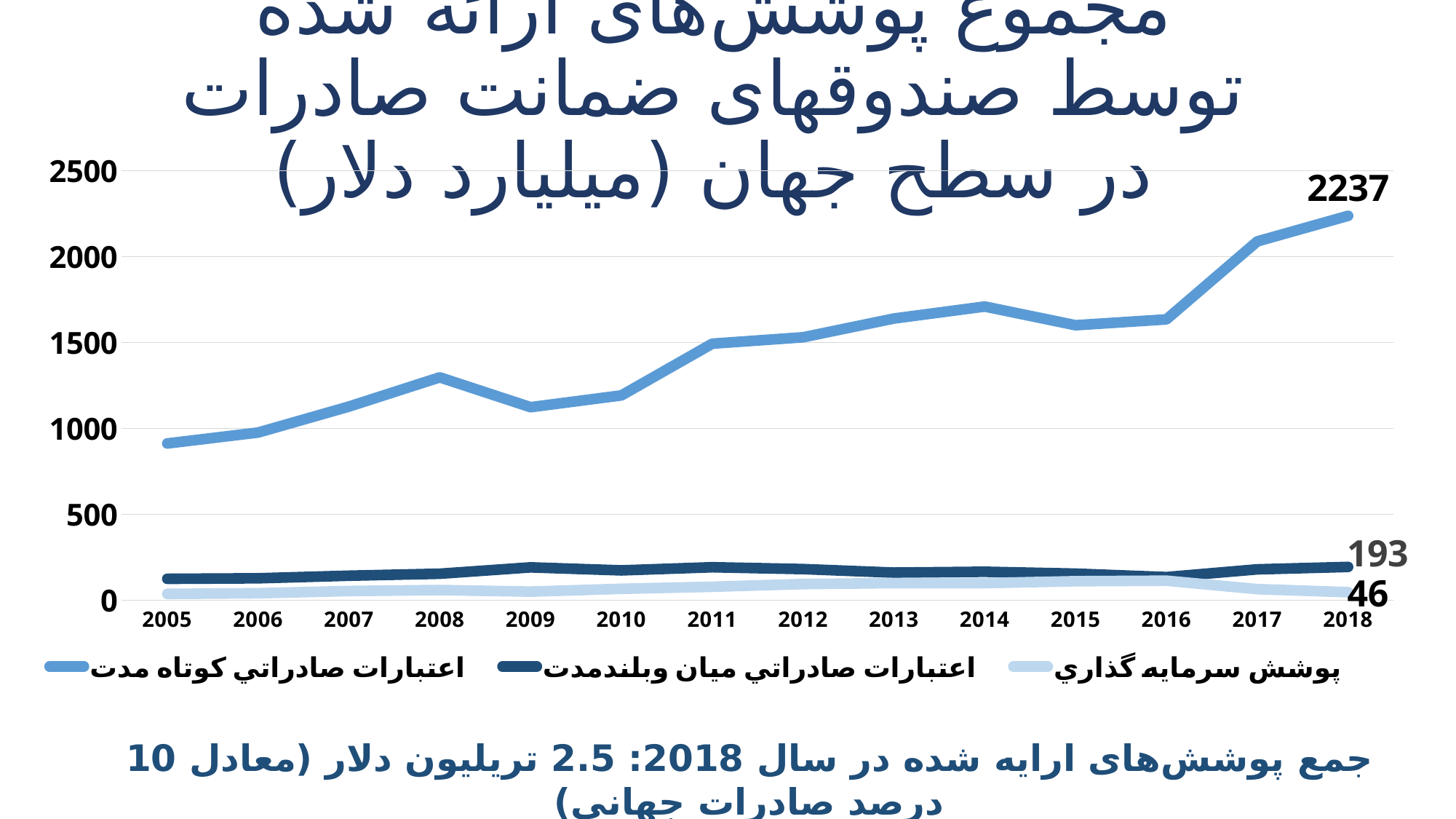
What is the value of the short-term export credits series (اعتبارات صادراتي كوتاه مدت) in 2018? 2237 What kind of chart is shown on the slide? line chart Does the short-term export credits series generally rise or fall from 2005 to 2018? rise Is the value for the short-term export credits series in 2009 greater or less than 1500? less How many series does the legend list? 3 Is the value for the short-term export credits series in 2005 greater or less than 1000? less In 2018, which series has the higher value: short-term export credits or medium and long-term export credits? اعتبارات صادراتي كوتاه مدت (short-term export credits) What is the value of the medium and long-term export credits series (اعتبارات صادراتي ميان وبلندمدت) in 2018? 193 What is the difference between the 2018 values of the short-term export credits series and the medium and long-term export credits series? 2044 Is the value for the short-term export credits series in 2017 greater or less than 2000? greater How many years are shown on the x axis? 14 What is the value of the investment coverage series (پوشش سرمايه گذاري) in 2018? 46